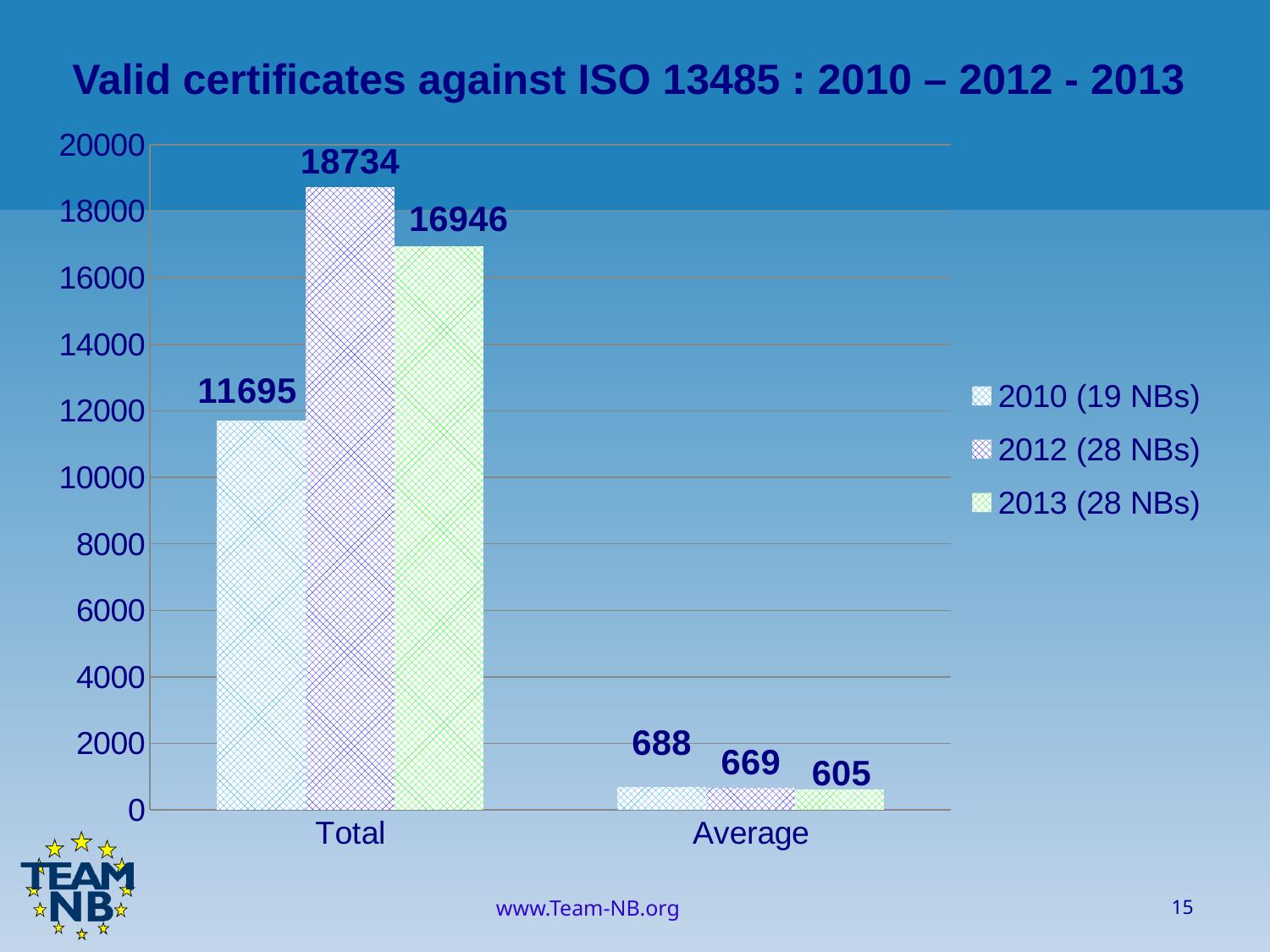
How many series does the legend list? 3 What is the difference between the Total values for 2012 (28 NBs) and 2013 (28 NBs)? 1788 Which is larger: the Total value for 2010 (19 NBs) or the Total value for 2013 (28 NBs)? 2013 (28 NBs) What is the Total value for 2010 (19 NBs)? 11695 Is the Total value for 2013 (28 NBs) greater or less than 16000? greater What is the difference between the Average values for 2010 (19 NBs) and 2012 (28 NBs)? 19 What is the Average value for 2013 (28 NBs)? 605 What is the Total value for 2012 (28 NBs)? 18734 What is the title of the chart? Valid certificates against ISO 13485 : 2010 – 2012 - 2013 What kind of chart is shown on the slide? Bar chart Which series has the highest Total value? 2012 (28 NBs) Which series has the lowest Average value? 2013 (28 NBs)